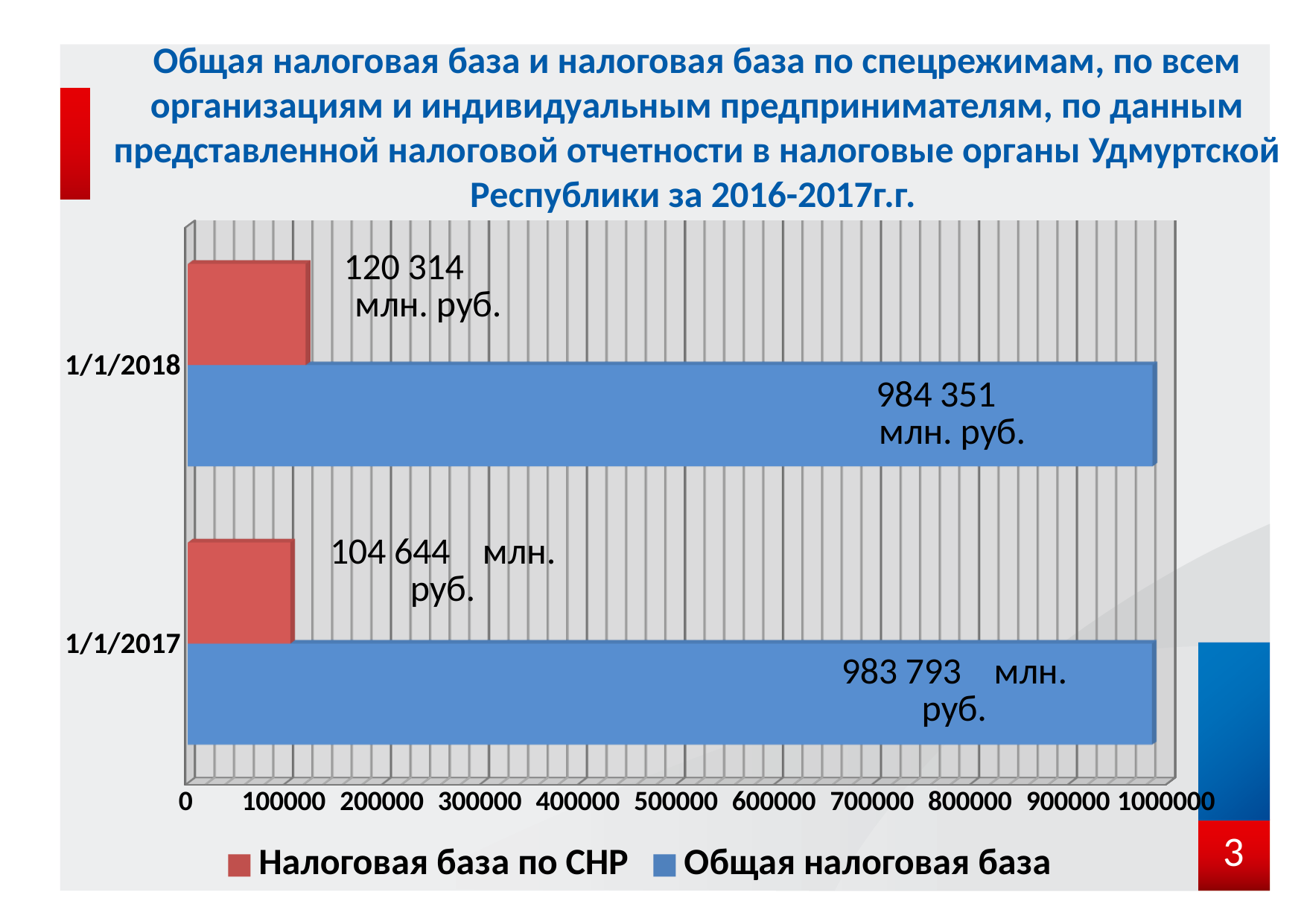
How many series does the legend list? 2 What is the value of Общая налоговая база for 1/1/2018? 984 351 млн. руб. What is the value of Налоговая база по СНР for 1/1/2017? 104 644 млн. руб. Is the value of Налоговая база по СНР for 1/1/2018 greater or less than 100000? greater What is the value of Налоговая база по СНР for 1/1/2018? 120 314 млн. руб. How many categories are shown on the vertical axis? 2 What is the value of Общая налоговая база for 1/1/2017? 983 793 млн. руб. What type of chart is shown on the slide? bar chart What is the difference between Общая налоговая база for 1/1/2018 and for 1/1/2017? 558 млн. руб. Which category has the higher value for Налоговая база по СНР, 1/1/2018 or 1/1/2017? 1/1/2018 By how much did Налоговая база по СНР increase from 1/1/2017 to 1/1/2018? 15 670 млн. руб. What is the difference between Общая налоговая база and Налоговая база по СНР for 1/1/2018? 864 037 млн. руб.